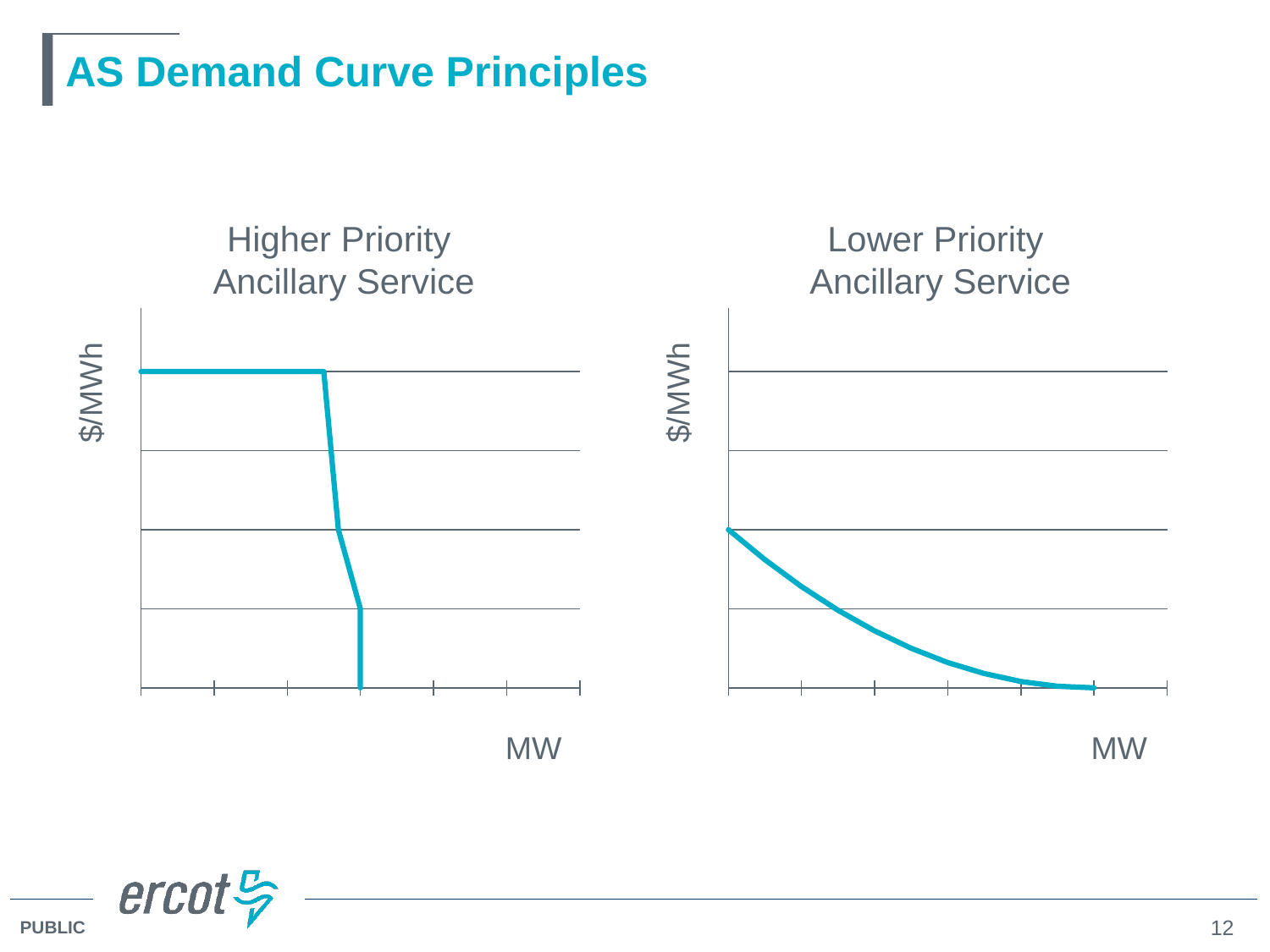
In the 'Higher Priority Ancillary Service' chart, does the curve rise or fall as MW increases? fall What is the label on the vertical axis of the 'Higher Priority Ancillary Service' chart? $/MWh What kind of chart is the 'Higher Priority Ancillary Service' chart? line chart What kind of chart is the 'Lower Priority Ancillary Service' chart? line chart How many charts are shown on the slide? 2 What is the label on the horizontal axis of the 'Lower Priority Ancillary Service' chart? MW In the 'Lower Priority Ancillary Service' chart, does the curve rise or fall as MW increases? fall